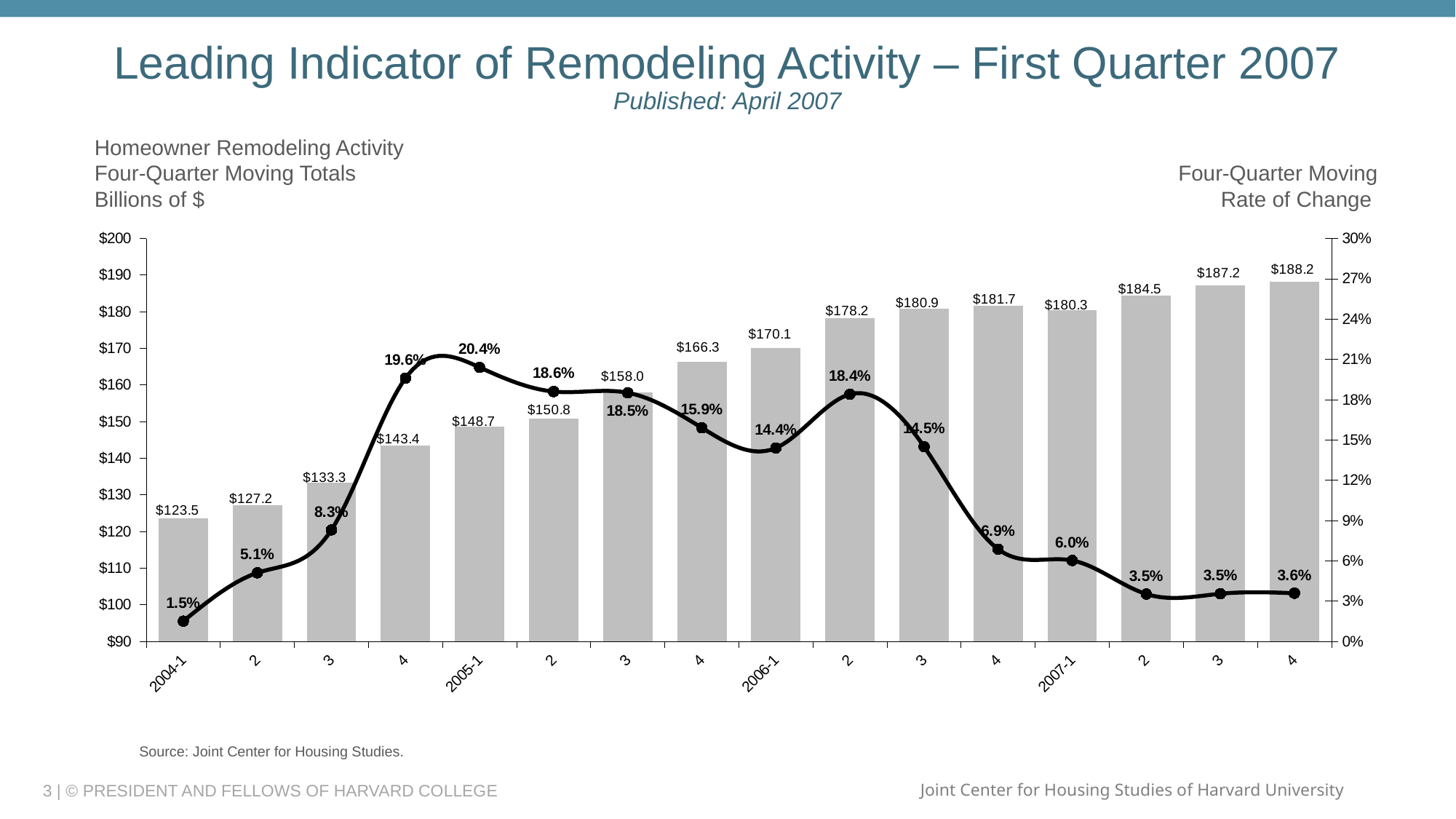
How many quarters are shown on the x axis? 16 What is the four-quarter moving rate of change for 2005-1? 20.4% What unit is shown on the left axis of the chart? Billions of $ Which quarter has the highest four-quarter moving total? 2007-4 ($188.2) What is the four-quarter moving total (bar value) for 2006-1? $170.1 Which quarter has the lowest four-quarter moving total? 2004-1 ($123.5) What kind of chart is this? A bar chart combined with a line chart What is the difference between the four-quarter moving totals for 2007-4 and 2007-3? $1.0 Which has the larger four-quarter moving total, 2006-4 or 2007-1? 2006-4 Which quarter has the highest four-quarter moving rate of change? 2005-1 (20.4%) Which quarter has the lowest four-quarter moving rate of change? 2004-1 (1.5%) Do the four-quarter moving totals (bars) generally rise or fall from 2004-1 to 2007-4? Rise